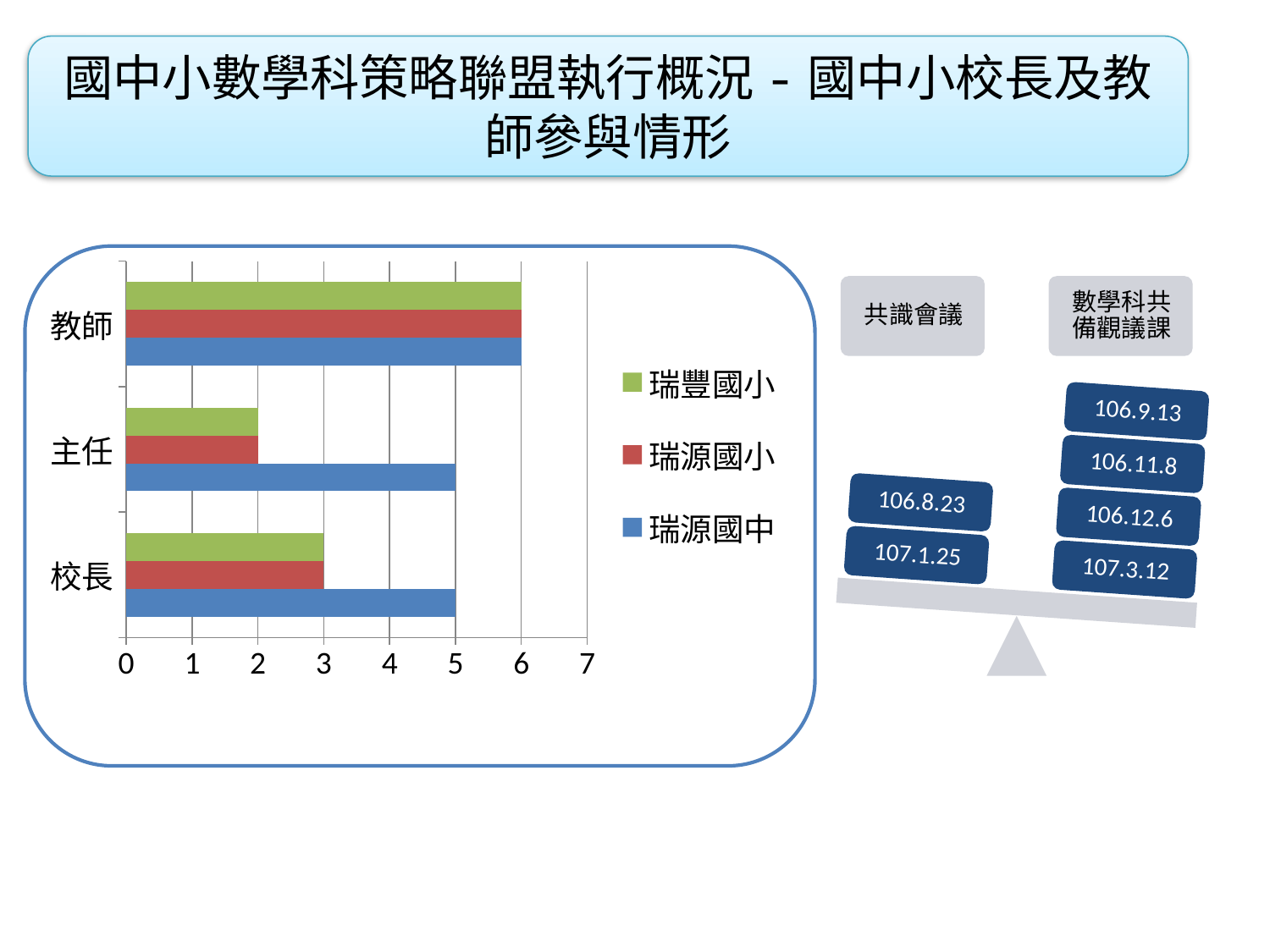
What is the value for 瑞源國小 in the 教師 category? 6 Is the value for 瑞源國中 in the 教師 category greater or less than 5? greater How many series does the chart legend list? 3 What is the value for 瑞源國中 in the 校長 category? 5 How many categories are shown on the chart's vertical axis? 3 What is the value for 瑞豐國小 in the 主任 category? 2 Which series is shown in blue in the chart legend? 瑞源國中 What is the difference between the 瑞源國中 and 瑞豐國小 values in the 主任 category? 3 Which is larger in the 校長 category: 瑞源國中 or 瑞源國小? 瑞源國中 Which category has the lowest value for 瑞源國小? 主任 Which category has the highest value for 瑞豐國小? 教師 What kind of chart is shown on the slide? bar chart